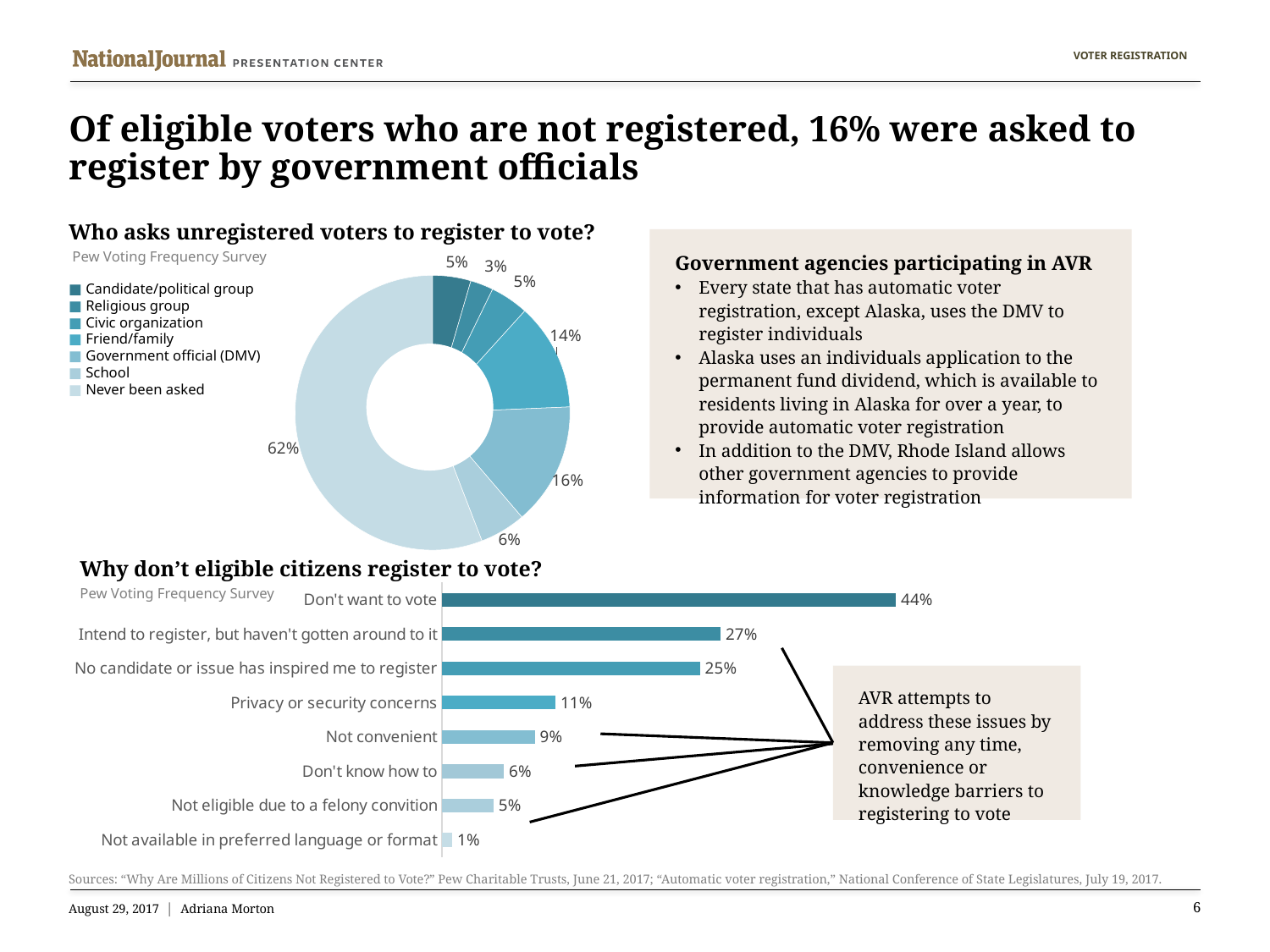
In the 'Who asks unregistered voters to register to vote?' chart, what percentage were asked by a government official (DMV)? 16% What kind of chart is 'Who asks unregistered voters to register to vote?' Donut (pie) chart In the 'Who asks unregistered voters to register to vote?' chart, what share of unregistered voters have never been asked to register? 62% In the 'Why don't eligible citizens register to vote?' chart, how many reasons are listed? 8 In the 'Why don't eligible citizens register to vote?' chart, what is the value for 'Not convenient'? 9% In the 'Who asks unregistered voters to register to vote?' chart, how many categories does the legend list? 7 In the 'Who asks unregistered voters to register to vote?' chart, which is larger: Friend/family or School? Friend/family What kind of chart is 'Why don't eligible citizens register to vote?' Bar chart In the 'Who asks unregistered voters to register to vote?' chart, which category has the smallest share? Religious group In the 'Why don't eligible citizens register to vote?' chart, what percentage say they don't want to vote? 44% In the 'Why don't eligible citizens register to vote?' chart, which reason has the lowest value? Not available in preferred language or format In the 'Why don't eligible citizens register to vote?' chart, what is the difference between 'Intend to register, but haven't gotten around to it' and 'No candidate or issue has inspired me to register'? 2 percentage points